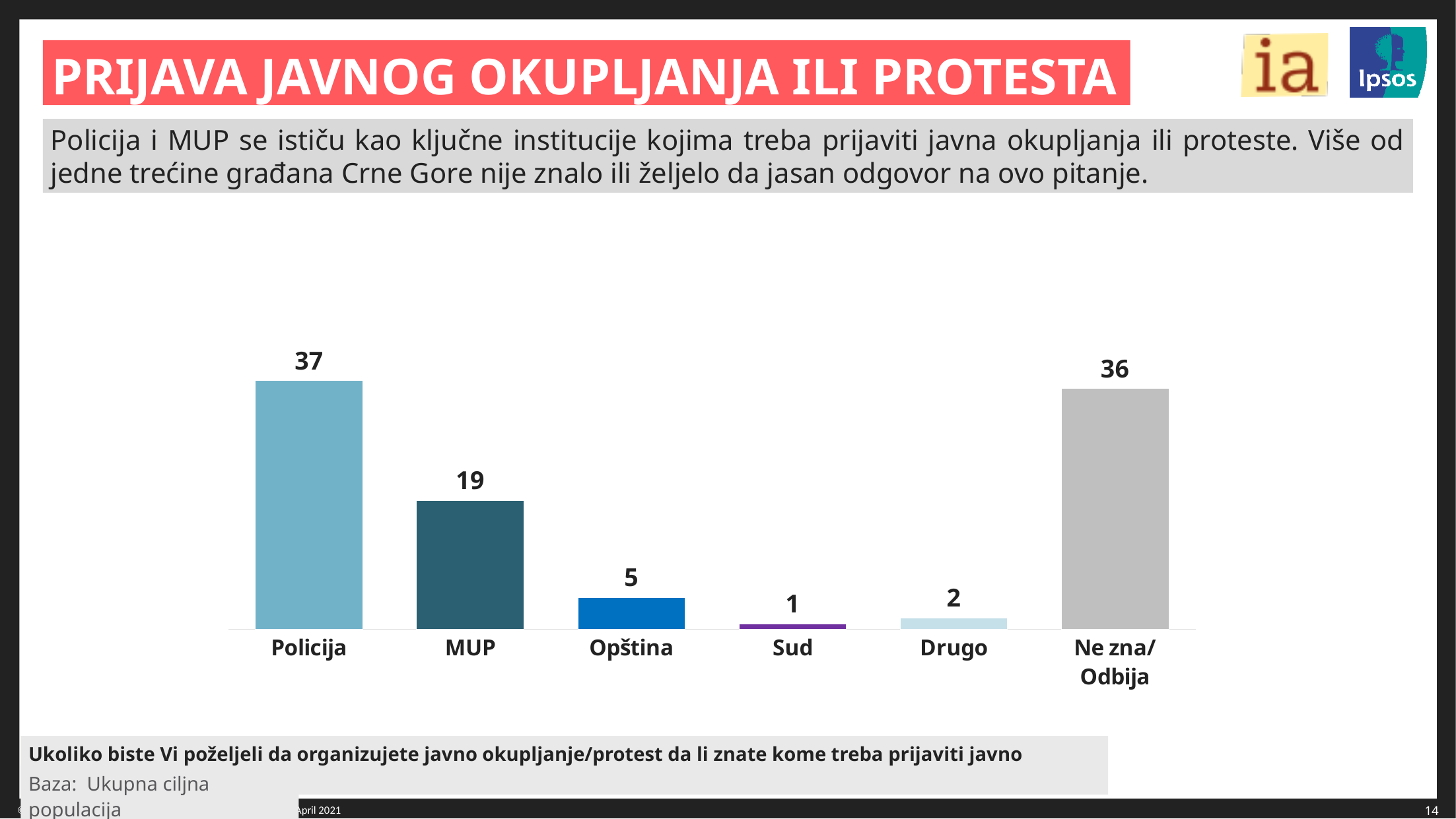
What is the value for Policija? 37 Which category has the highest value? Policija What is the value for MUP? 19 What is the value for Ne zna/Odbija? 36 Which is larger, the value for MUP or the value for Ne zna/Odbija? Ne zna/Odbija What is the difference between the values for Opština and Drugo? 3 How many categories are shown on the chart? 6 Which category has the lowest value? Sud What kind of chart is shown on the slide? Bar chart What is the value for Opština? 5 What is the difference between the values for Policija and MUP? 18 What is the title of the slide? PRIJAVA JAVNOG OKUPLJANJA ILI PROTESTA